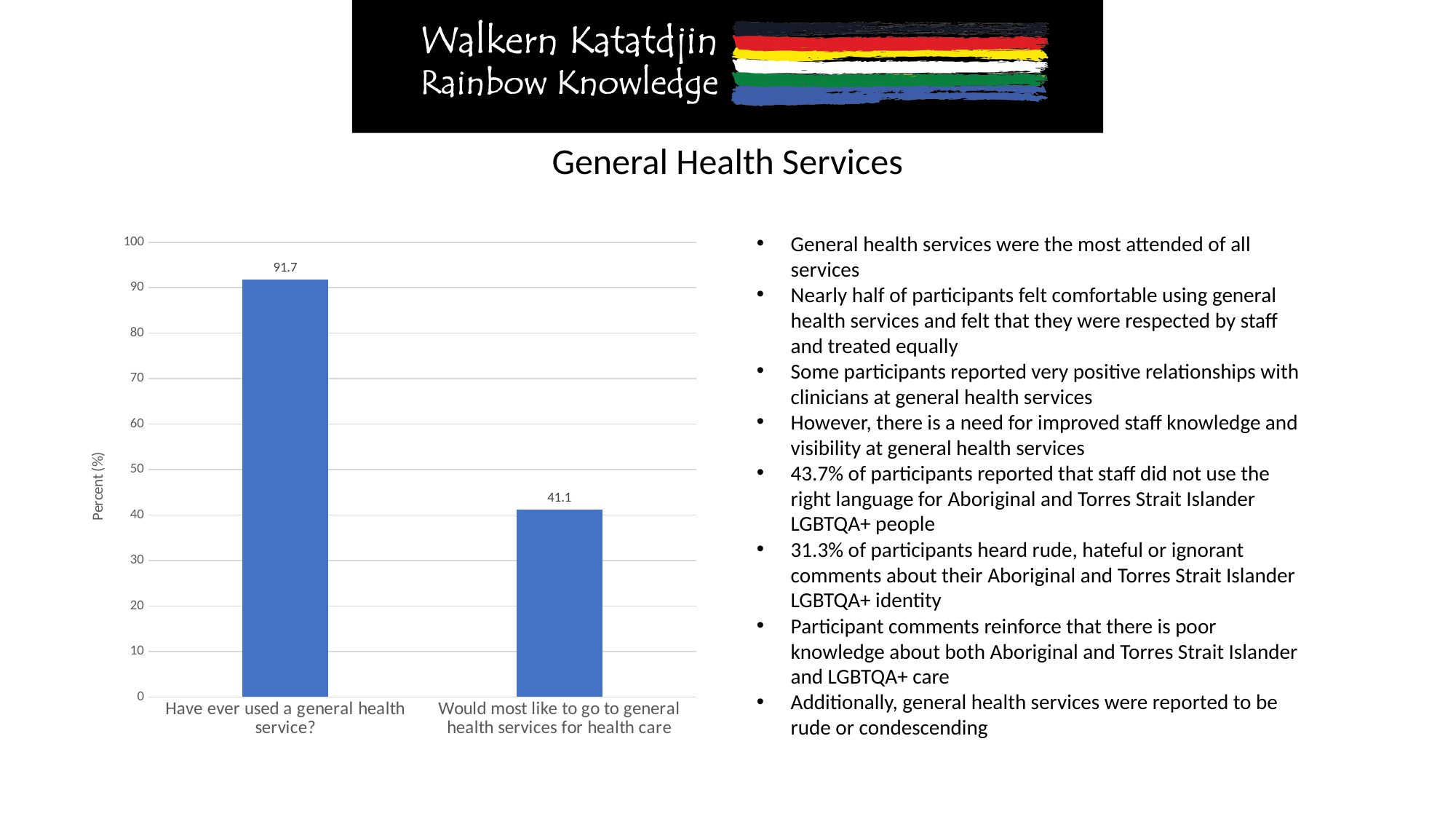
Which category has the highest value? Have ever used a general health service? Which category has the lowest value? Would most like to go to general health services for health care Do the values rise or fall from left to right along the x axis? fall What is the difference between the value for "Have ever used a general health service?" and the value for "Would most like to go to general health services for health care"? 50.6 Is the value for "Have ever used a general health service?" greater or less than 90? greater Which is larger: the value for "Have ever used a general health service?" or the value for "Would most like to go to general health services for health care"? Have ever used a general health service? How many categories are shown in the chart? 2 What is the value for "Would most like to go to general health services for health care"? 41.1 Is the value for "Would most like to go to general health services for health care" greater or less than 50? less What is the value for "Have ever used a general health service?"? 91.7 What kind of chart is shown on the slide? bar chart What is the label of the vertical axis of the chart? Percent (%)